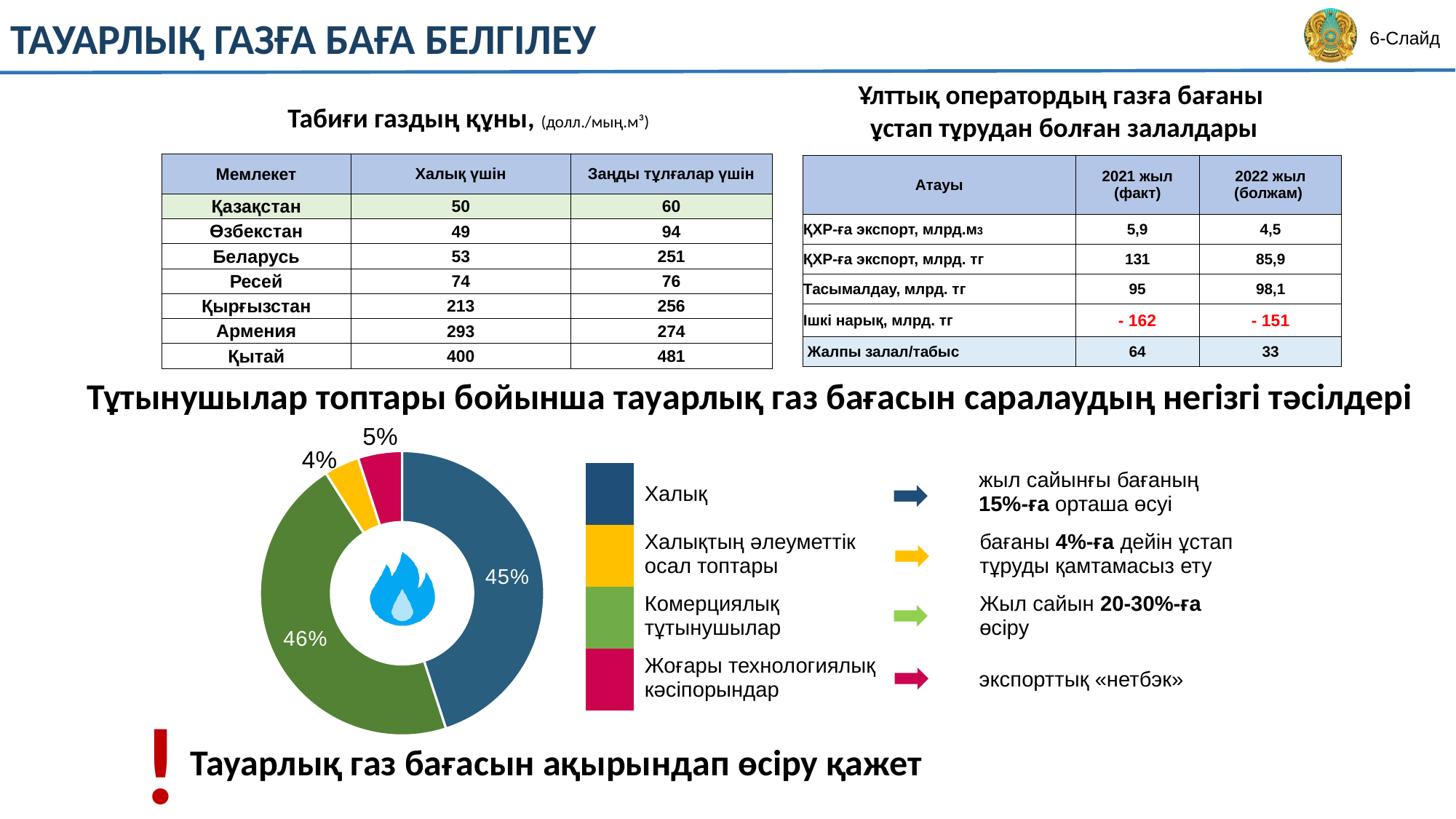
In the pie chart, what share is labelled for the Жоғары технологиялық кәсіпорындар slice? 5% In the pie chart, which is larger: the Жоғары технологиялық кәсіпорындар slice or the Халықтың әлеуметтік осал топтары slice? Жоғары технологиялық кәсіпорындар What colour is the Халық slice in the pie chart? Dark blue What colour is the Комерциялық тұтынушылар slice in the pie chart? Green In the pie chart, what share is labelled for the Халықтың әлеуметтік осал топтары slice? 4% Which category has the largest slice in the pie chart? Комерциялық тұтынушылар Which category has the smallest slice in the pie chart? Халықтың әлеуметтік осал топтары In the pie chart, what share is labelled for the Халық slice? 45% What kind of chart is shown at the bottom left of the slide? Pie chart (donut) How many categories does the pie chart show? 4 In the pie chart, what share is labelled for the Комерциялық тұтынушылар slice? 46% In the pie chart, what is the difference between the Комерциялық тұтынушылар share and the Халық share? 1%